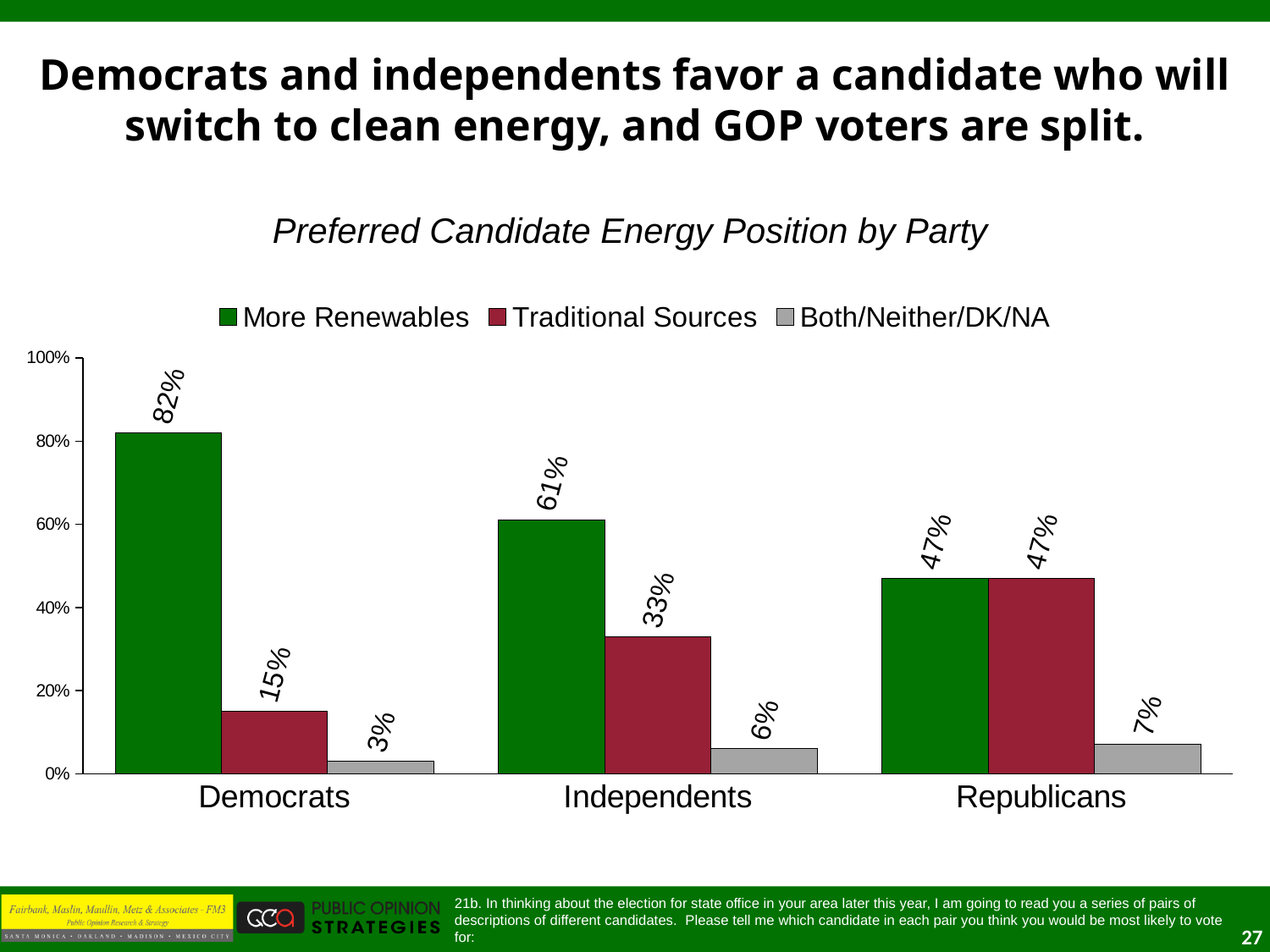
Which party group has the lowest Both/Neither/DK/NA value? Democrats What is the Both/Neither/DK/NA value for Republicans? 7% How many series does the legend list? 3 What is the Traditional Sources value for Independents? 33% How many party groups are shown on the x axis? 3 Is the More Renewables value for Independents greater or less than 40%? greater What is the difference between the More Renewables and Traditional Sources values for Independents? 28% What kind of chart is shown on the slide? Bar chart What percentage of Democrats prefer a candidate favoring More Renewables? 82% Which party group has the highest More Renewables value? Democrats Which is larger for Democrats: More Renewables or Traditional Sources? More Renewables What is the title of the chart? Preferred Candidate Energy Position by Party